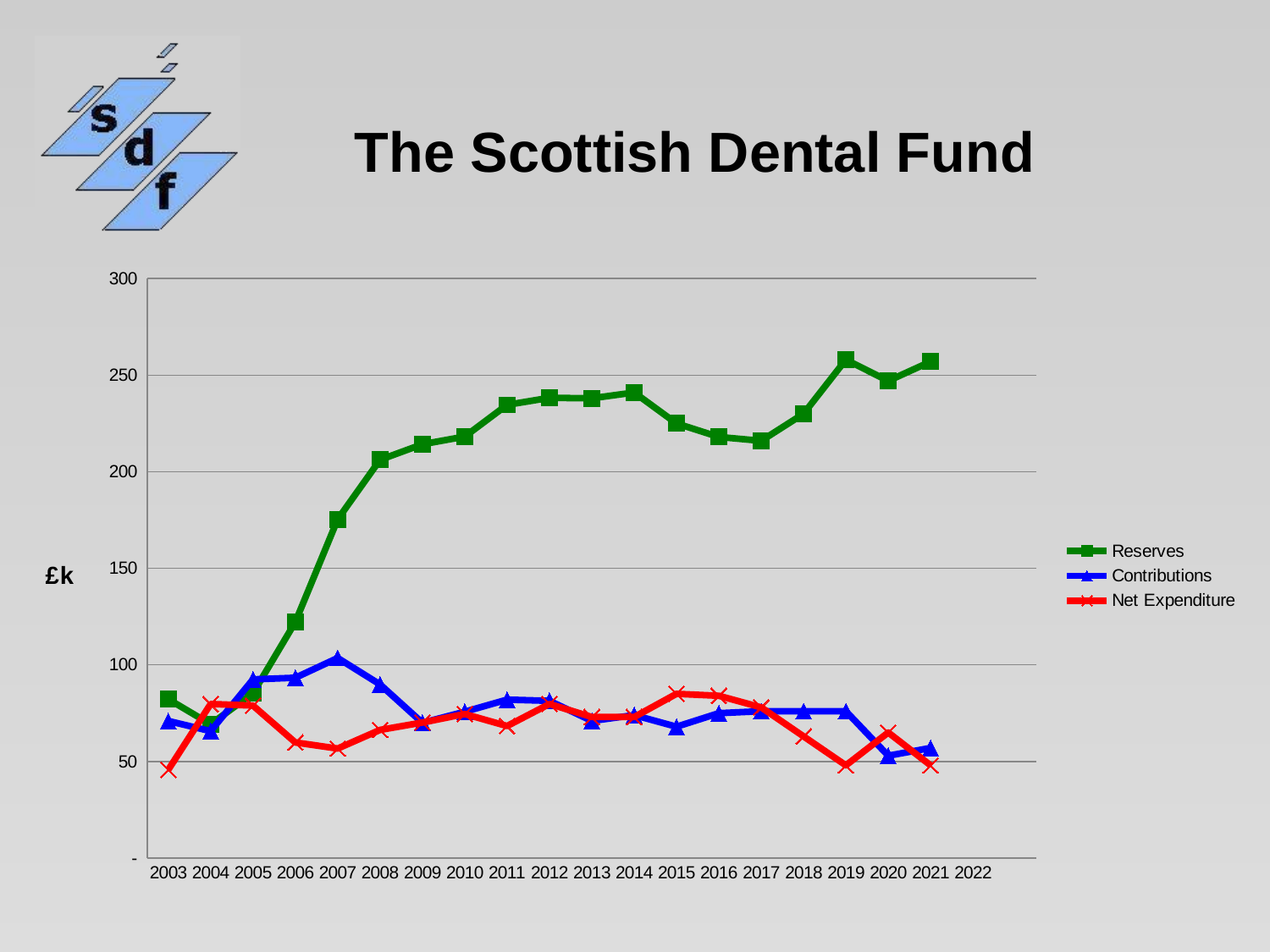
Is the value for Reserves in 2007 greater or less than 200? less How many years are labelled along the x axis? 20 Is the value for Reserves in 2008 greater or less than 200? greater In 2010, which is larger: Reserves or Contributions? Reserves Is the value for Net Expenditure in 2003 greater or less than 50? less What kind of chart is shown on the slide? Line chart How many series does the legend list? 3 What unit label is shown on the vertical axis? £k What are the three series named in the legend? Reserves, Contributions, Net Expenditure In which year do Contributions reach their highest value? 2007 In which year are Reserves at their lowest? 2004